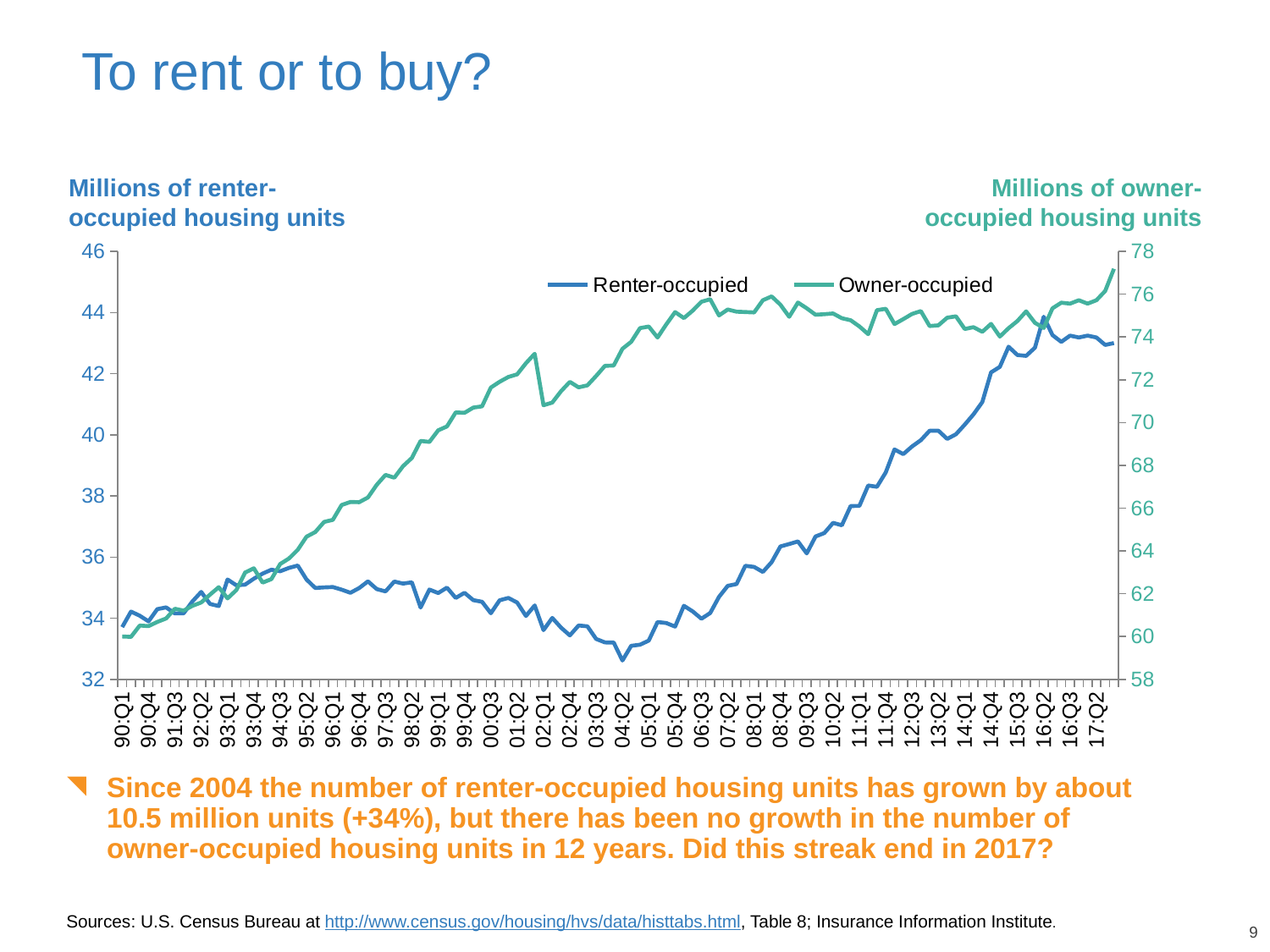
Is the Renter-occupied value at 17:Q2 greater or less than 42? greater How many series does the chart's legend list? 2 Around which quarter does the Renter-occupied series reach its lowest point? 04:Q2 Is the Renter-occupied value at 90:Q1 greater or less than 36? less Is the Renter-occupied value at 04:Q2 greater or less than 34? less What are the two series named in the chart's legend? Renter-occupied and Owner-occupied Does the Renter-occupied series rise or fall from 04:Q2 to 17:Q2? Rise What is the title of the left vertical axis of the chart? Millions of renter-occupied housing units What kind of chart is shown on the slide? Line chart